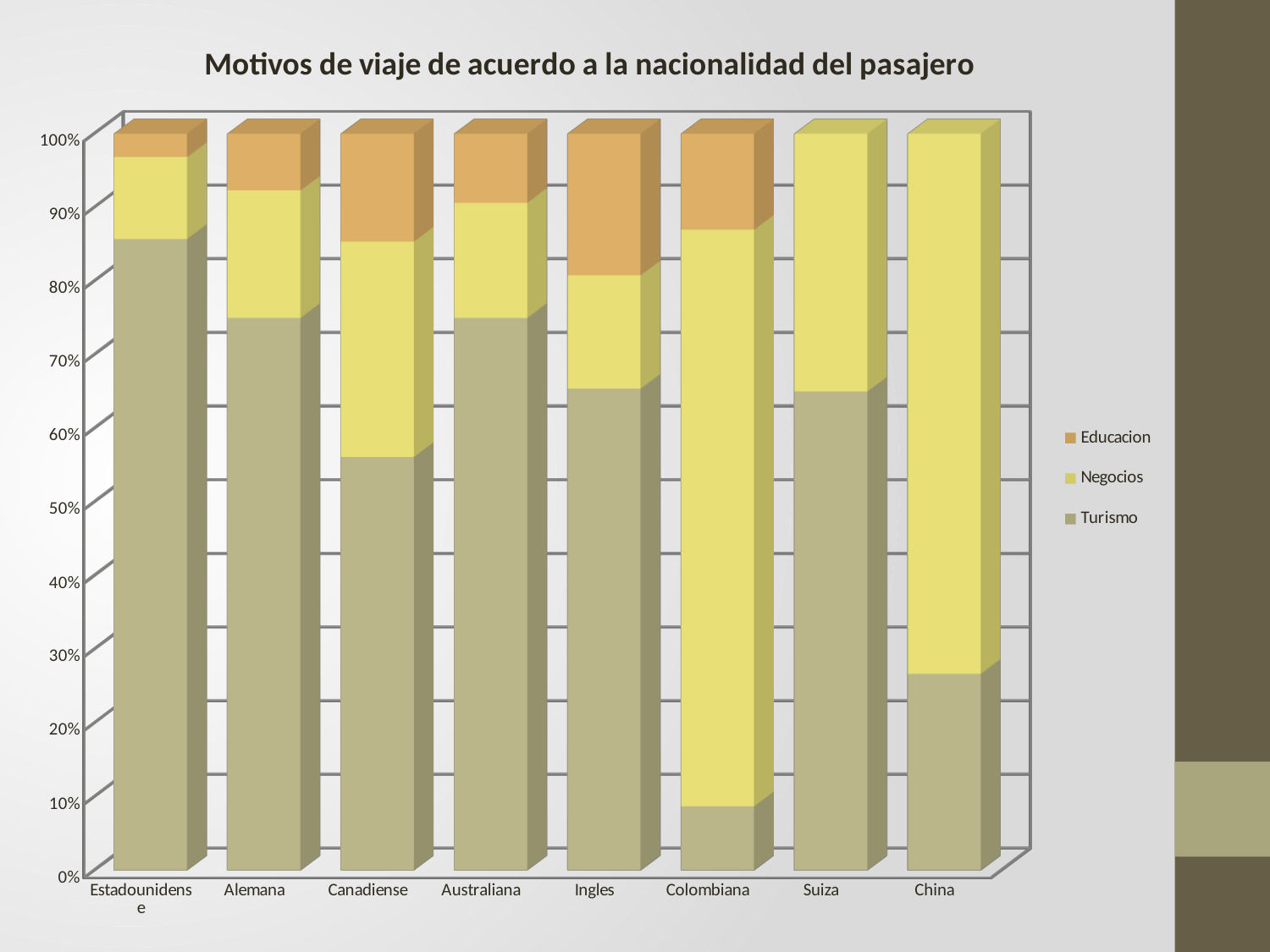
Is the Turismo share for China greater or less than 40%? less Which nationalities show no Educacion segment in their bars? Suiza and China Is the Turismo share for Colombiana greater or less than 20%? less How many nationality categories are shown on the x axis? 8 Which has a larger Turismo share, Canadiense or Ingles? Ingles Which nationality has the largest Educacion share? Ingles Is the Turismo share for Estadounidense greater or less than 80%? greater Which nationality has the smallest Turismo share? Colombiana Which nationality has the largest Turismo share? Estadounidense How many series does the legend list? 3 What kind of chart is shown on the slide? Stacked bar chart What is the title of the chart? Motivos de viaje de acuerdo a la nacionalidad del pasajero